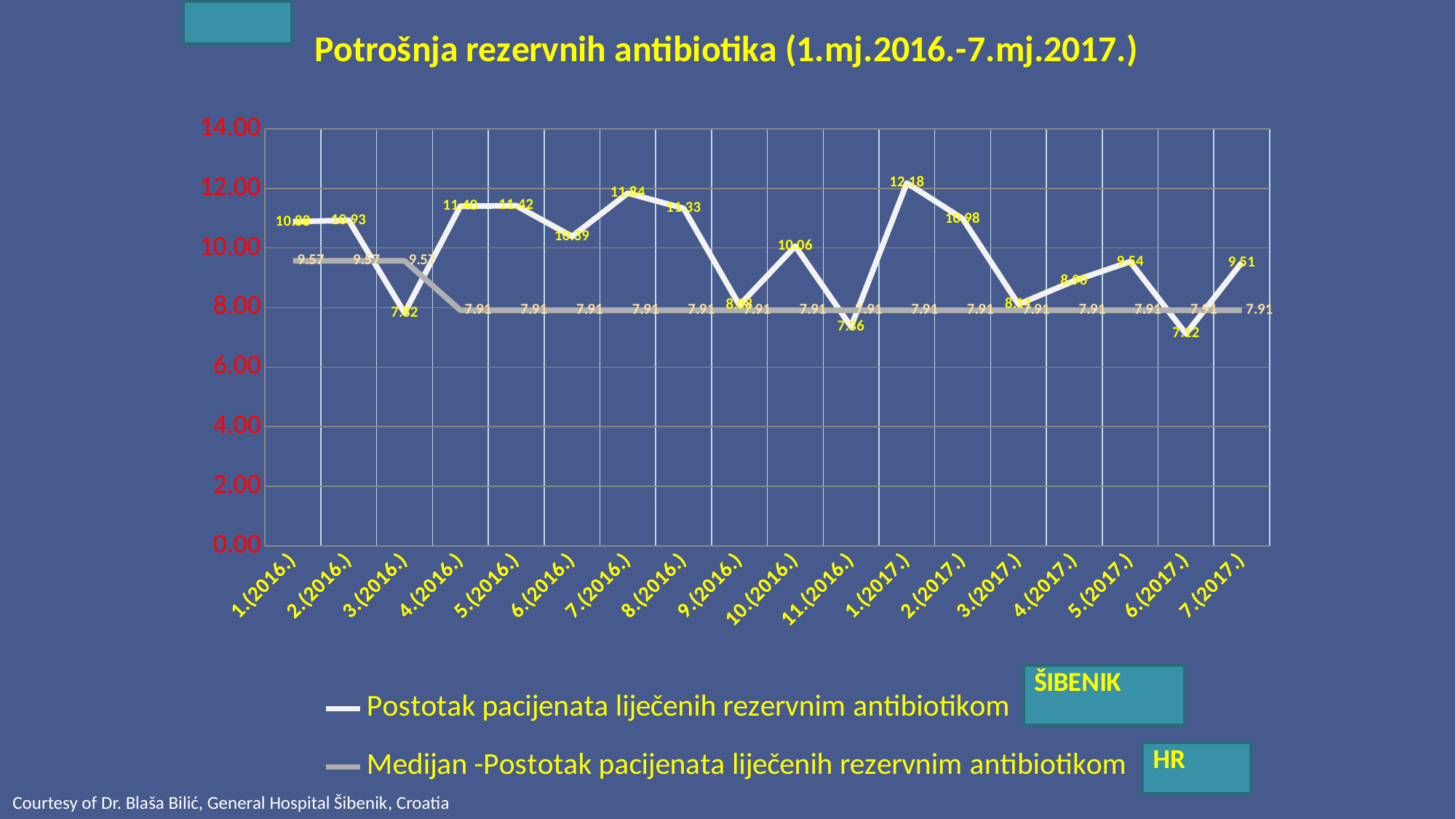
In which month does 'Postotak pacijenata liječenih rezervnim antibiotikom' reach its highest value? 1.(2017.) What is the value of the 'Medijan' series for 1.(2016.)? 9.57 What kind of chart is shown on the slide? line chart What is the value of the 'Medijan' series for 7.(2017.)? 7.91 How many months (categories) are plotted along the x axis? 18 Which month has the larger value for 'Postotak pacijenata liječenih rezervnim antibiotikom': 3.(2016.) or 4.(2016.)? 4.(2016.) By how much does 'Postotak pacijenata liječenih rezervnim antibiotikom' exceed the 'Medijan' value in 1.(2017.)? 4.27 What is the value of 'Postotak pacijenata liječenih rezervnim antibiotikom' for 1.(2017.)? 12.18 What is the value of 'Postotak pacijenata liječenih rezervnim antibiotikom' for 5.(2017.)? 9.54 In which month does 'Postotak pacijenata liječenih rezervnim antibiotikom' reach its lowest value? 6.(2017.) Is the value of 'Postotak pacijenata liječenih rezervnim antibiotikom' for 7.(2016.) greater or less than 10.00? greater How many series does the legend list? 2